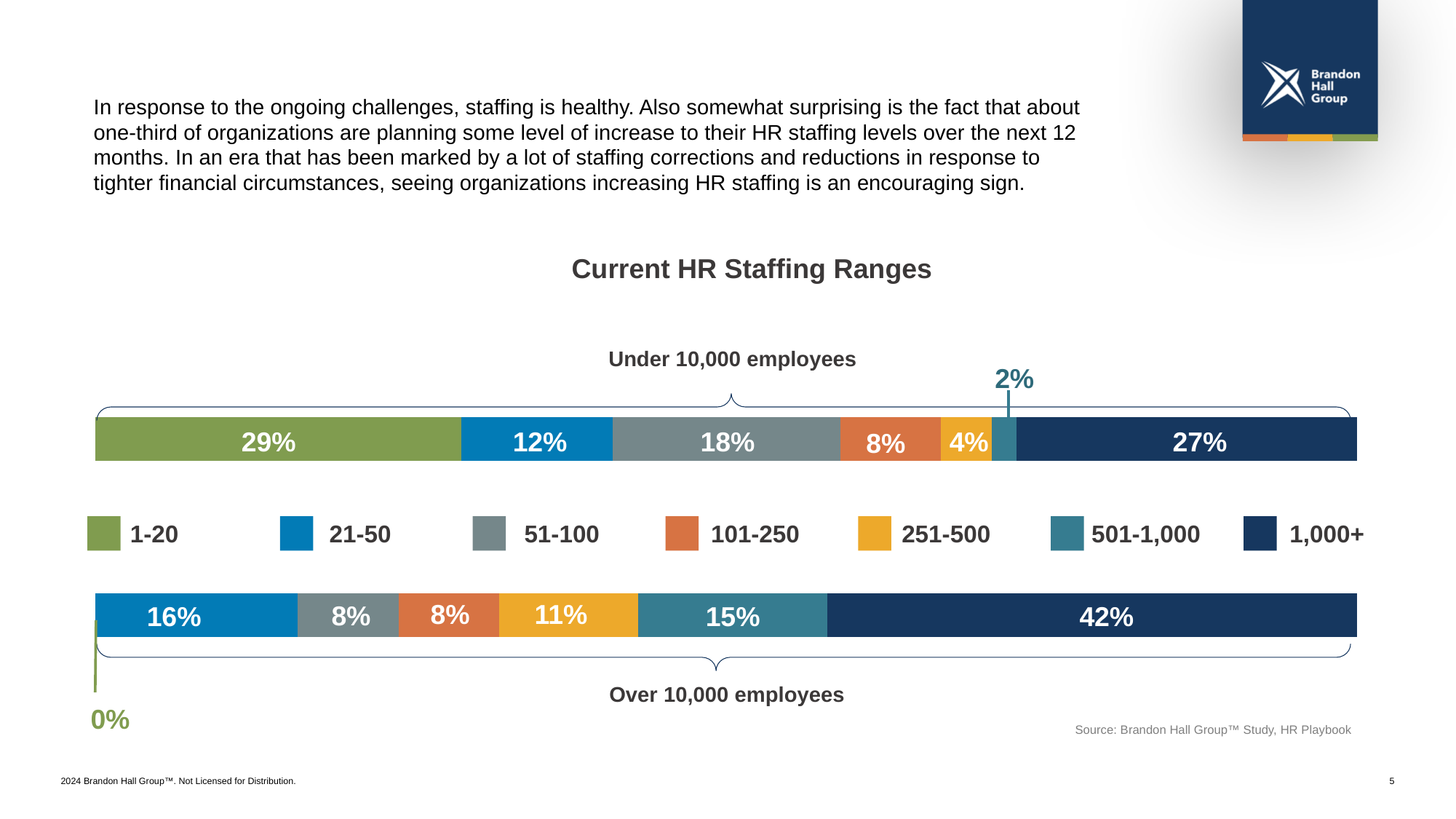
What percentage of organizations with over 10,000 employees have an HR staff of 1,000+? 42% What kind of chart is shown on the slide? Stacked bar chart What is the total of the 21-50 and 51-100 shares for organizations with under 10,000 employees? 30% What percentage of organizations with over 10,000 employees have an HR staff of 1-20? 0% Which is larger: the 251-500 share for under 10,000 employees or the 251-500 share for over 10,000 employees? Over 10,000 employees What is the title of the chart? Current HR Staffing Ranges Which HR staffing range is the largest share for organizations with under 10,000 employees? 1-20 What percentage of organizations with under 10,000 employees have an HR staff of 1-20? 29% What is the difference between the 1,000+ share for over 10,000 employees and the 1,000+ share for under 10,000 employees? 15% How many HR staffing ranges does the legend list? 7 What percentage of organizations with under 10,000 employees have an HR staff of 501-1,000? 2% Which HR staffing range is the smallest share for organizations with over 10,000 employees? 1-20